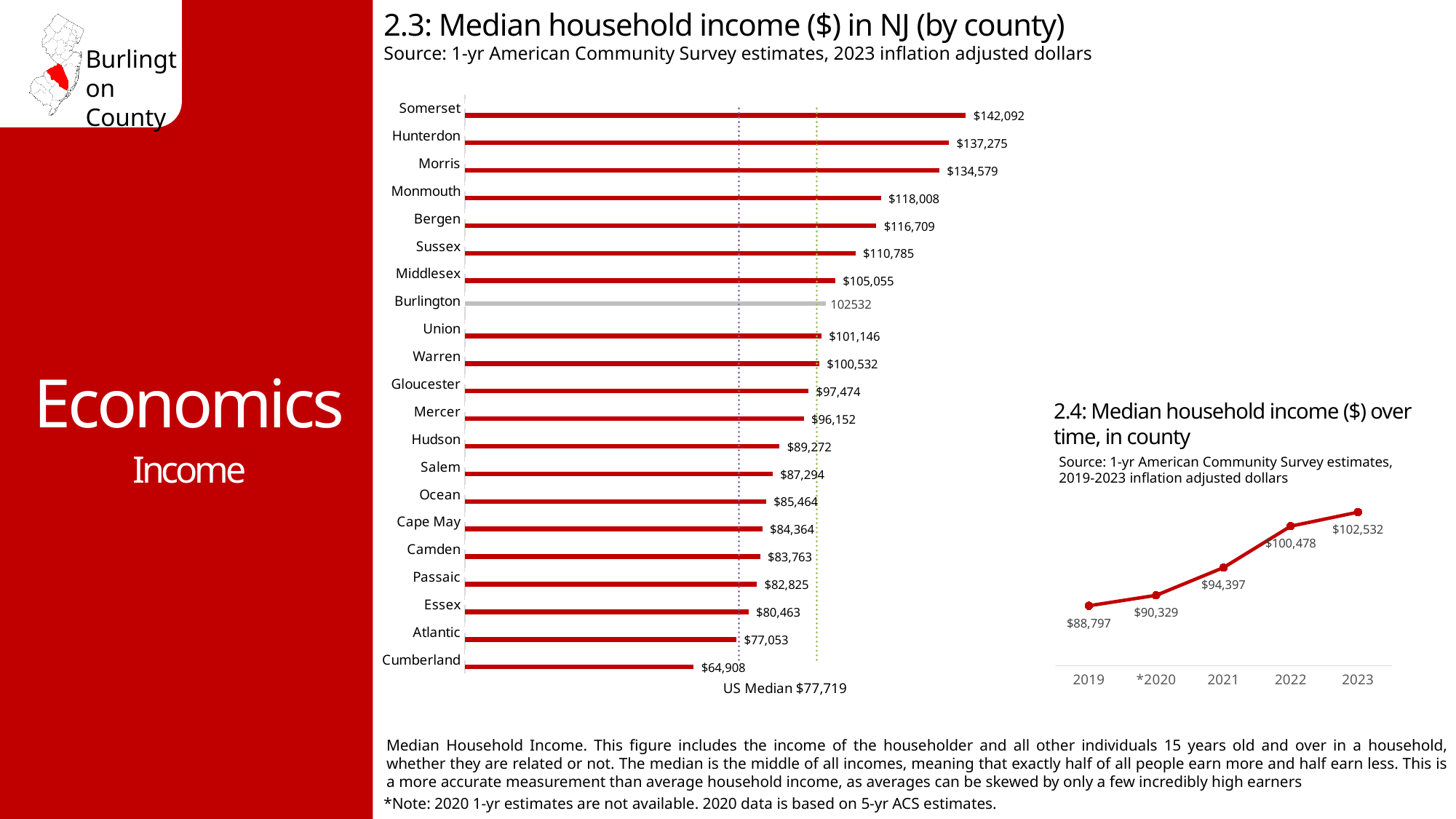
In chart 2.4 (Median household income over time, in county), do the values rise or fall from 2019 to 2023? Rise In chart 2.4 (Median household income over time, in county), what is the median household income for 2019? $88,797 In chart 2.3 (Median household income in NJ by county), what US median value is noted below the chart? $77,719 In chart 2.3 (Median household income in NJ by county), which county has the lowest median household income? Cumberland In chart 2.3 (Median household income in NJ by county), how many counties are shown? 21 In chart 2.3 (Median household income in NJ by county), what is the median household income for Cumberland? $64,908 In chart 2.3 (Median household income in NJ by county), what is the median household income for Somerset? $142,092 In chart 2.3 (Median household income in NJ by county), what is the difference between the median household incomes of Somerset and Cumberland? $77,184 In chart 2.3 (Median household income in NJ by county), which county has the highest median household income? Somerset In chart 2.3 (Median household income in NJ by county), which county has a higher median household income, Monmouth or Bergen? Monmouth In chart 2.4 (Median household income over time, in county), what is the difference between the 2023 and 2019 values? $13,735 What kind of chart is chart 2.3 (Median household income in NJ by county)? Bar chart